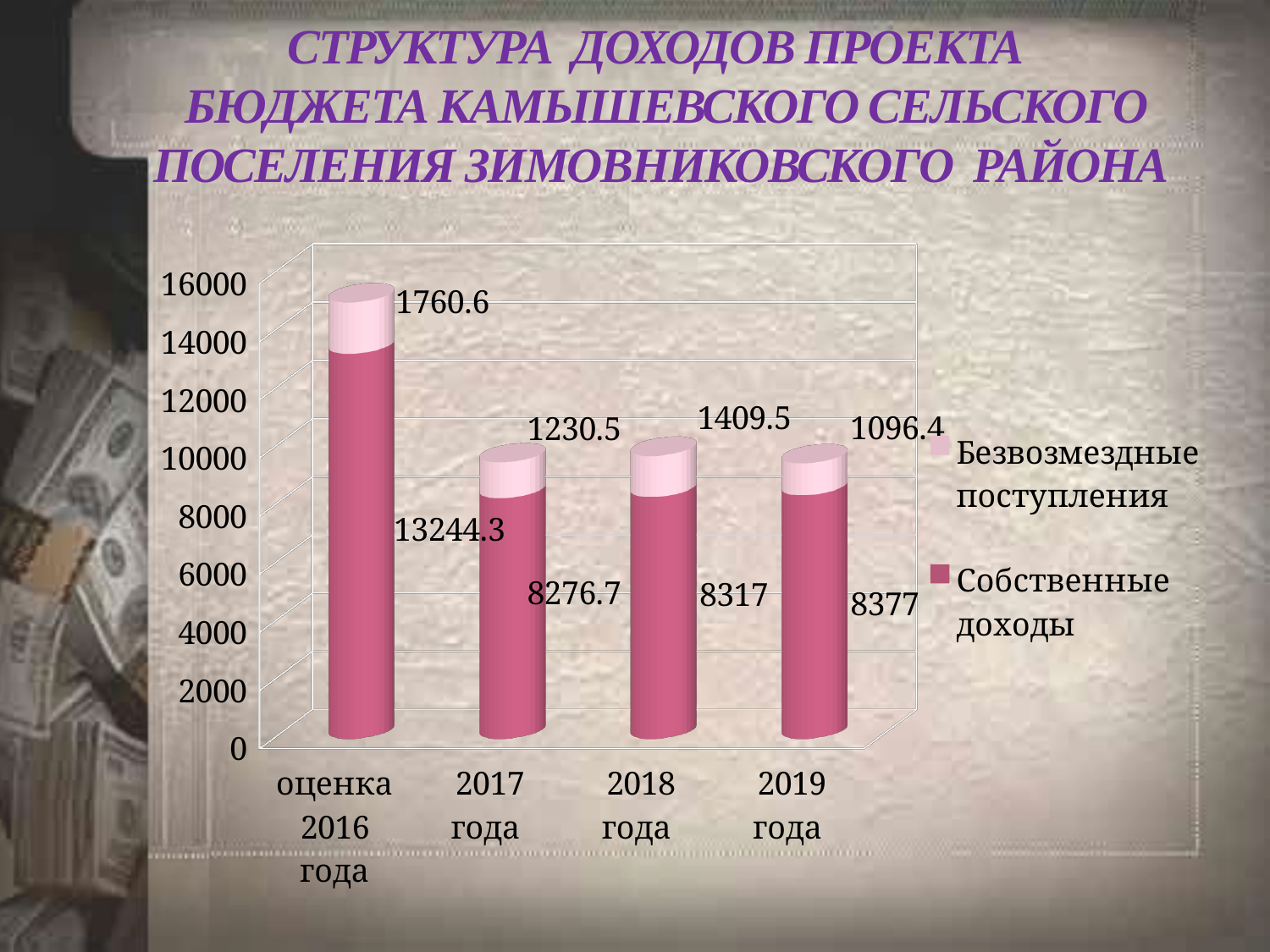
Which category has the highest value of Безвозмездные поступления? оценка 2016 года Which is larger: Безвозмездные поступления for 2017 года or for 2018 года? 2018 года What is the total of the stacked bar for 2019 года? 9473.4 What is the value of Безвозмездные поступления for 2018 года? 1409.5 What is the difference between Собственные доходы for оценка 2016 года and for 2017 года? 4967.6 How many categories are shown on the x axis? 4 How many series does the legend list? 2 Which category has the lowest value of Собственные доходы? 2017 года Which series is shown in the darker pink colour? Собственные доходы What is the value of Собственные доходы for оценка 2016 года? 13244.3 What kind of chart is shown on the slide? Stacked bar chart What is the value of Собственные доходы for 2019 года? 8377